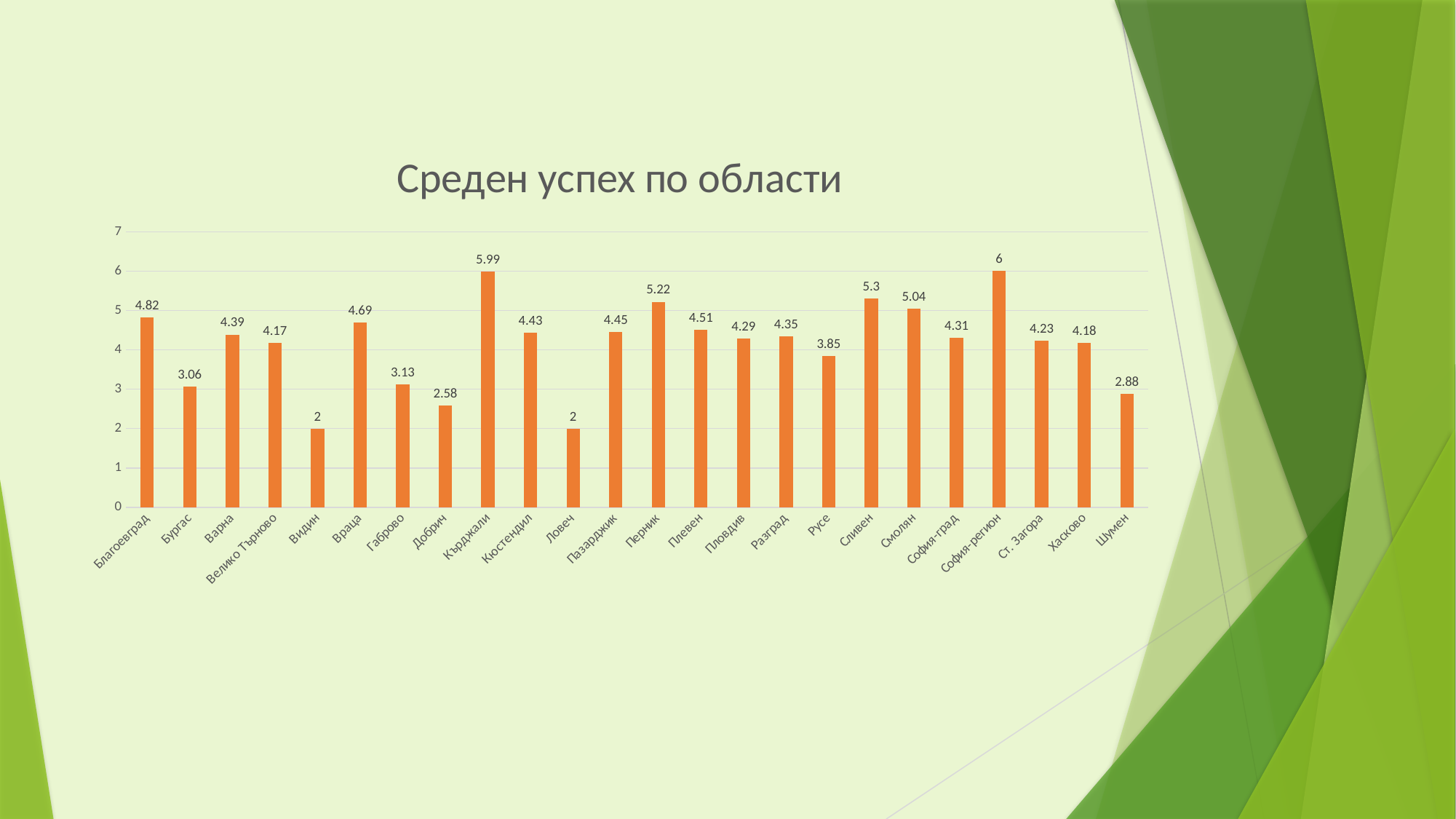
Which category has the highest value? София-регион Is the value for Габрово greater or less than 4? less What is the difference between the values for Перник and Русе? 1.37 How many categories are shown on the x axis? 24 Which is larger, the value for Сливен or the value for Плевен? Сливен What is the value for Бургас? 3.06 What kind of chart is shown on the slide? bar chart What is the difference between the values for Благоевград and Добрич? 2.24 What is the value for Кърджали? 5.99 What is the value for Шумен? 2.88 What is the value for Смолян? 5.04 What is the title of the chart? Среден успех по области